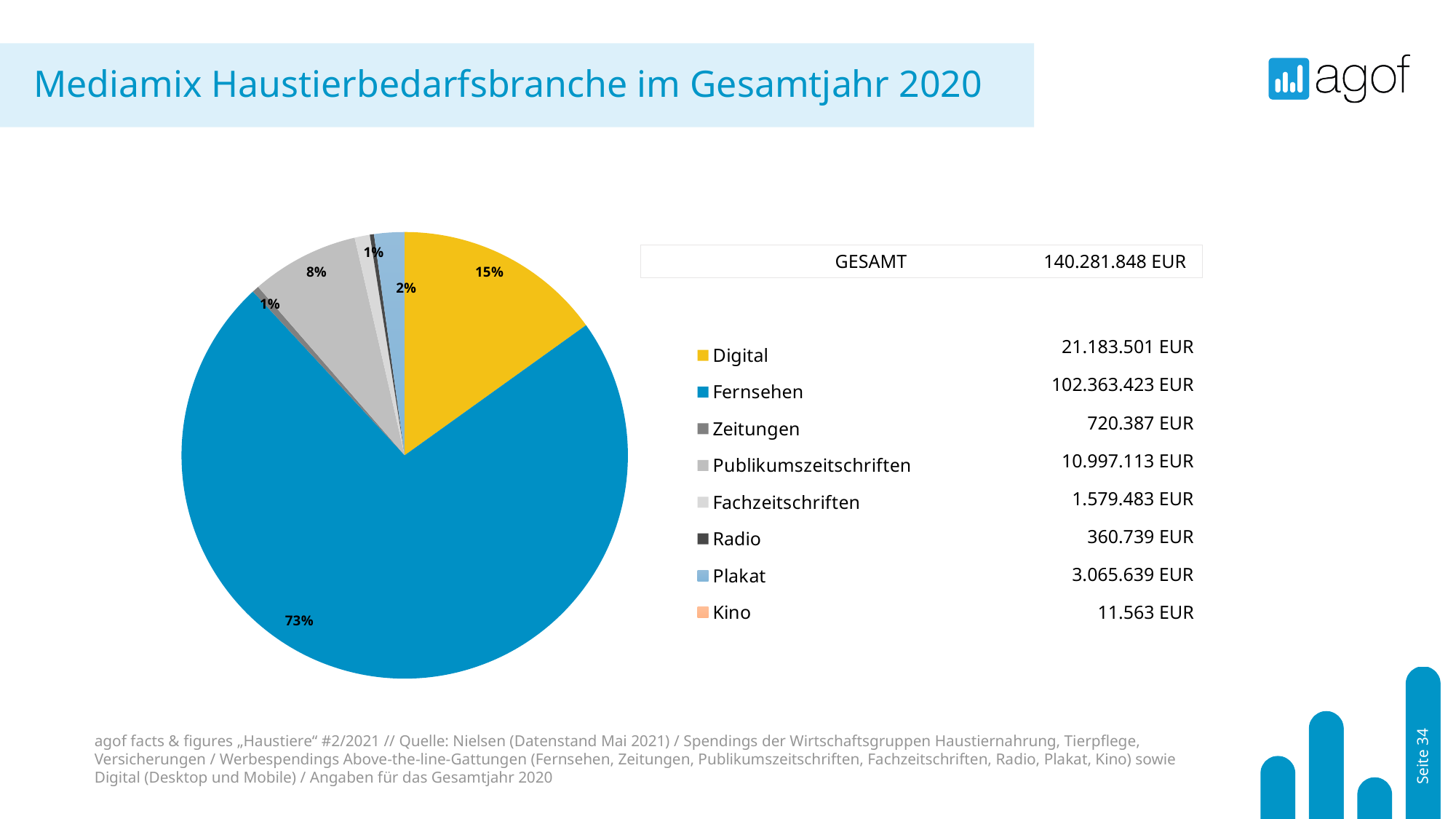
What share of the pie does Digital account for? 15% Which has the larger spending value, Digital or Publikumszeitschriften? Digital What is the GESAMT (total) value shown on the slide? 140.281.848 EUR What is the spending value listed for Fernsehen? 102.363.423 EUR What type of chart is shown on the slide? pie chart What share of the pie does Publikumszeitschriften account for? 8% Which category has the smallest spending value in the legend? Kino How many categories does the legend list? 8 What is the spending value listed for Kino? 11.563 EUR What share of the pie does Fernsehen account for? 73% What is the spending value listed for Plakat? 3.065.639 EUR Which category has the largest share of the pie? Fernsehen